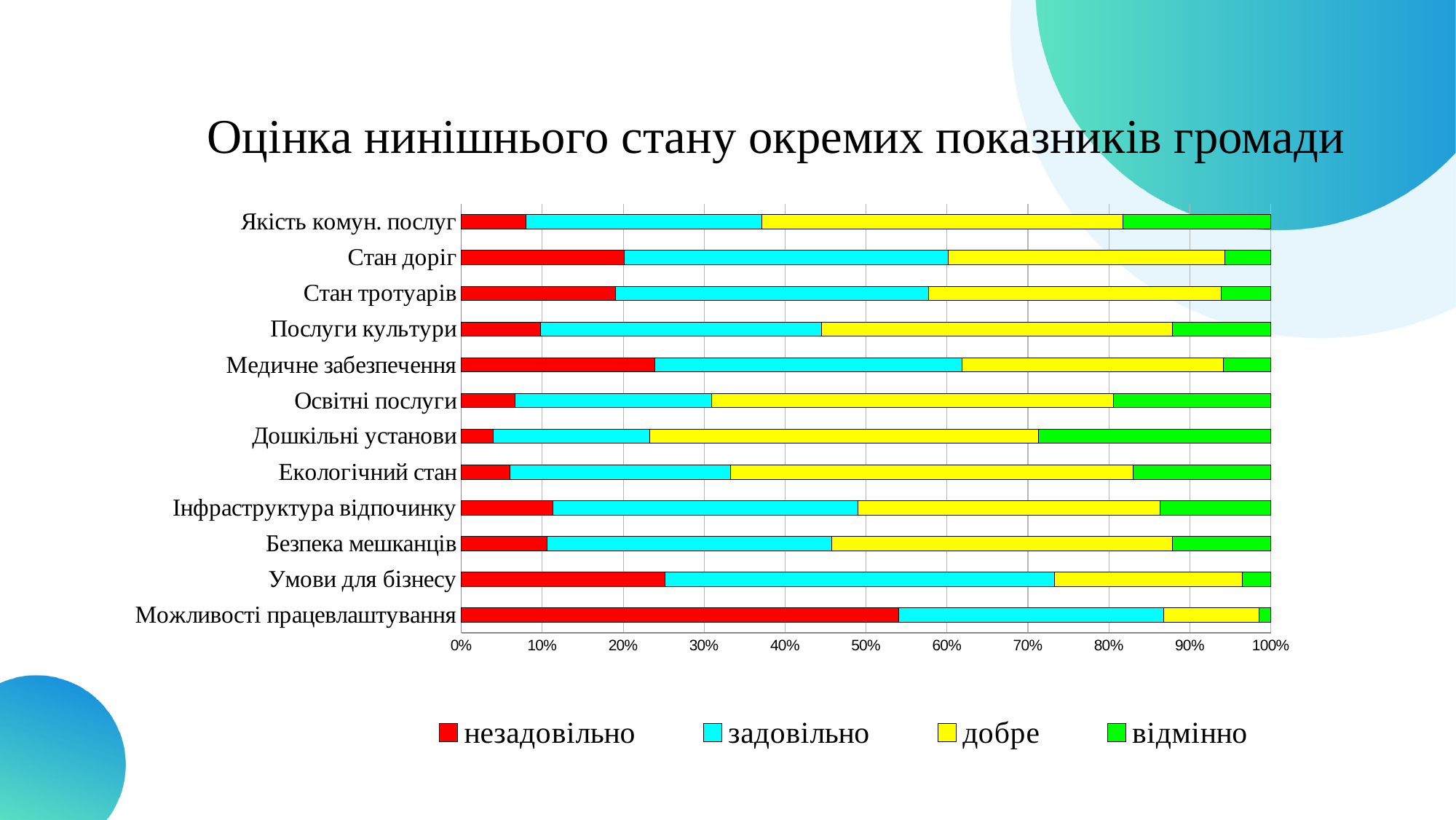
Which has a larger "незадовільно" share: "Умови для бізнесу" or "Стан доріг"? Умови для бізнесу Which category has the largest "незадовільно" (red) share? Можливості працевлаштування Which category has the smallest "відмінно" (green) share? Можливості працевлаштування Is the "незадовільно" share for "Якість комун. послуг" greater or less than 10%? less What kind of chart is shown on the slide? Stacked bar chart How many series does the legend list? 4 Is the "незадовільно" share for "Можливості працевлаштування" greater or less than 50%? greater Which category has the largest "відмінно" (green) share? Дошкільні установи What does each stacked bar total on the x axis? 100% Which colour represents the series "незадовільно" in the legend? Red What is the title of the chart? Оцінка нинішнього стану окремих показників громади How many categories (indicators) are plotted on the chart? 12